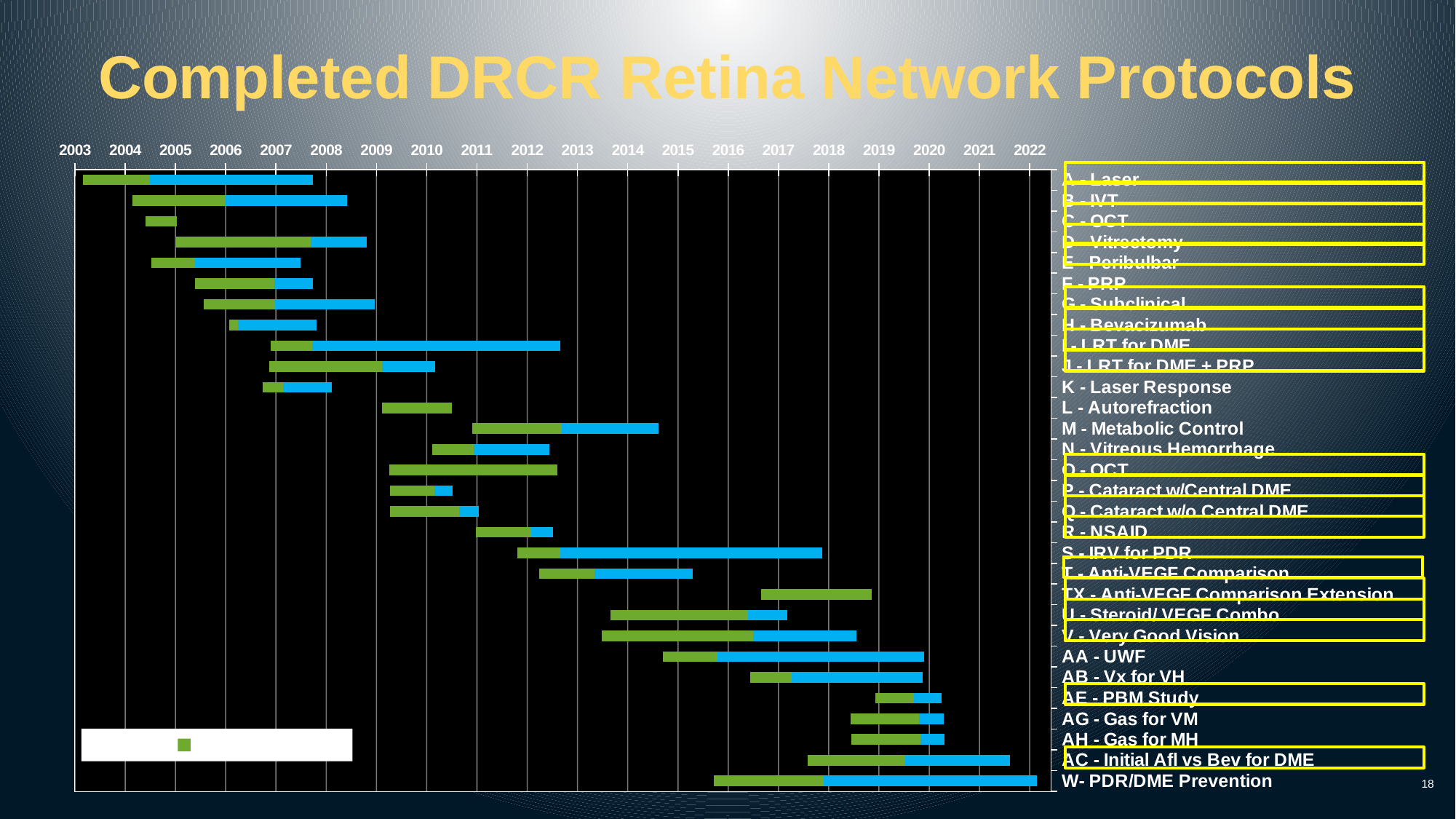
How many year labels appear along the x axis of the chart? 20 What is the title of the slide's chart? Completed DRCR Retina Network Protocols What is the last year shown on the x axis? 2022 Which protocol's bar extends latest (ends furthest right) in the chart? W- PDR/DME Prevention How many protocols (rows) are plotted in the chart? 30 What is the first year shown on the x axis? 2003 Which protocol's bar starts earlier, A - Laser or B - IVT? A - Laser What two colours are used for the bar segments in the chart? green and blue Which protocol has the shortest bar in the chart? C - OCT Does the bar for W- PDR/DME Prevention start before or after 2015? after Which protocol's bar starts earliest in the chart? A - Laser What kind of chart is shown on the slide? bar chart